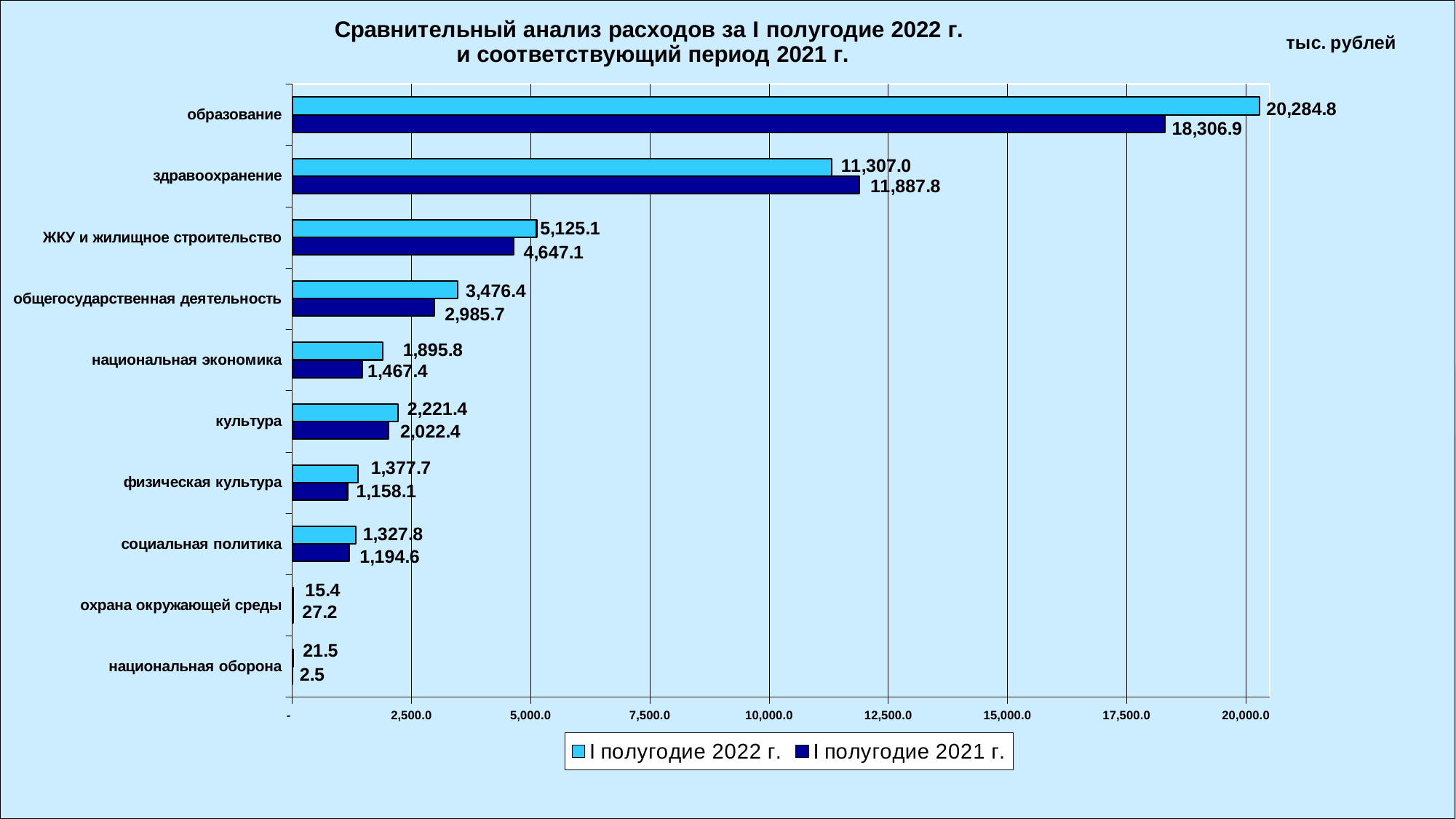
How many series does the legend list? 2 For охрана окружающей среды, which series has the larger value: I полугодие 2022 г. or I полугодие 2021 г.? I полугодие 2021 г. Which category has the lowest value in the I полугодие 2021 г. series? национальная оборона How many categories are shown on the chart? 10 What is the value for образование in the I полугодие 2022 г. series? 20,284.8 What is the difference between the I полугодие 2021 г. and I полугодие 2022 г. values for здравоохранение? 580.8 What kind of chart is shown on the slide? bar chart What is the difference between the I полугодие 2022 г. and I полугодие 2021 г. values for образование? 1,977.9 What is the value for национальная оборона in the I полугодие 2021 г. series? 2.5 What is the value for здравоохранение in the I полугодие 2021 г. series? 11,887.8 Is the I полугодие 2022 г. value for ЖКУ и жилищное строительство greater or less than 5,000.0? greater Which category has the highest value in the I полугодие 2022 г. series? образование